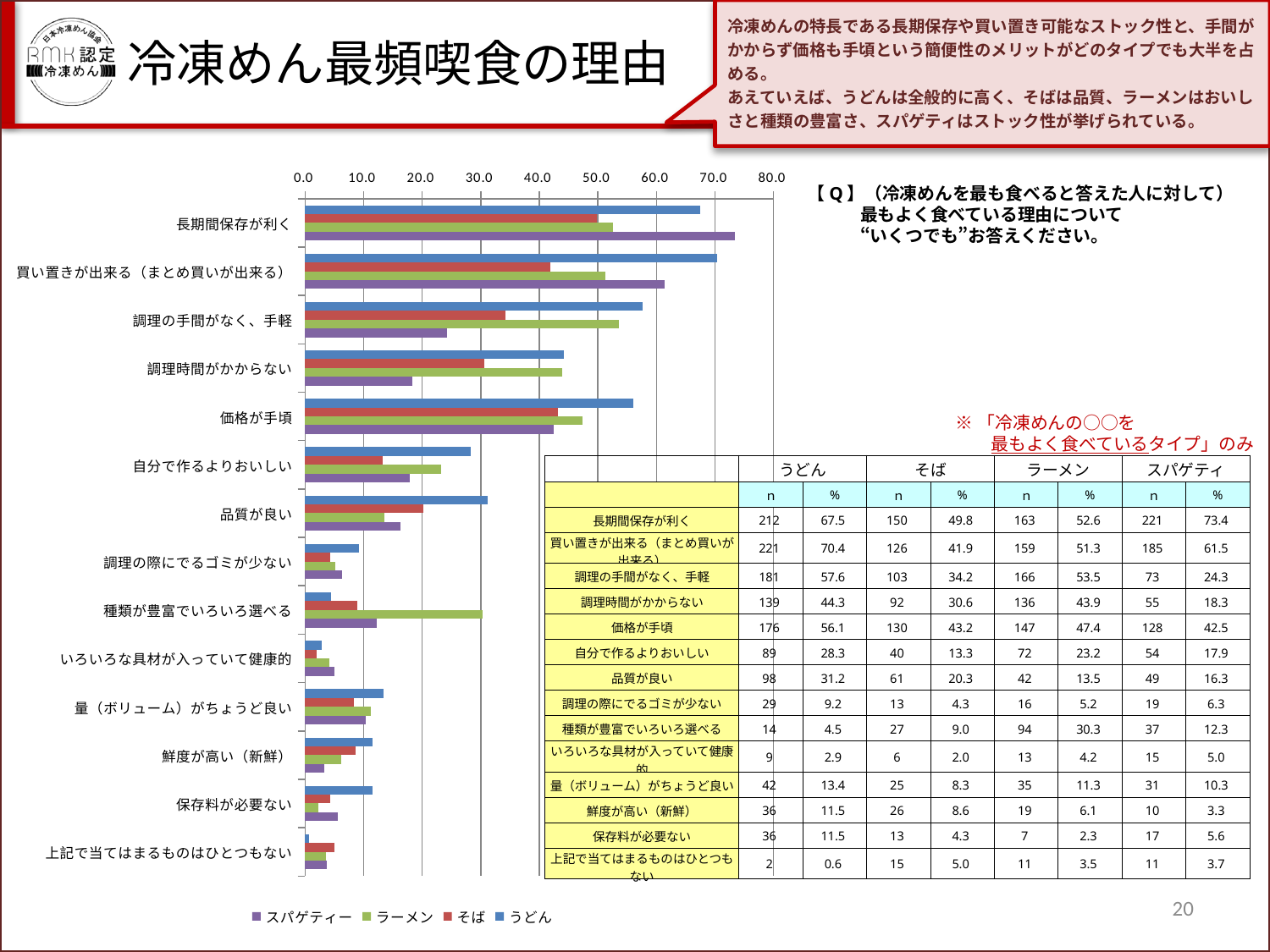
Which colour represents うどん in the chart legend? blue Is the スパゲティ value for 調理の手間がなく、手軽 greater or less than 30.0? less What is the ラーメン value (%) for 種類が豊富でいろいろ選べる? 30.3 For 長期間保存が利く, what is the difference between the スパゲティ value and the そば value (in percentage points)? 23.6 For 種類が豊富でいろいろ選べる, which is larger: the ラーメン value or the うどん value? ラーメン How many reason categories are plotted on the chart? 14 What kind of chart is shown on the slide? bar chart Which category has the lowest うどん value? 上記で当てはまるものはひとつもない Is the うどん value for 価格が手頃 greater or less than 50.0? greater Which category has the highest スパゲティ value? 長期間保存が利く How many series does the chart legend list? 4 What is the うどん value (%) for 長期間保存が利く? 67.5